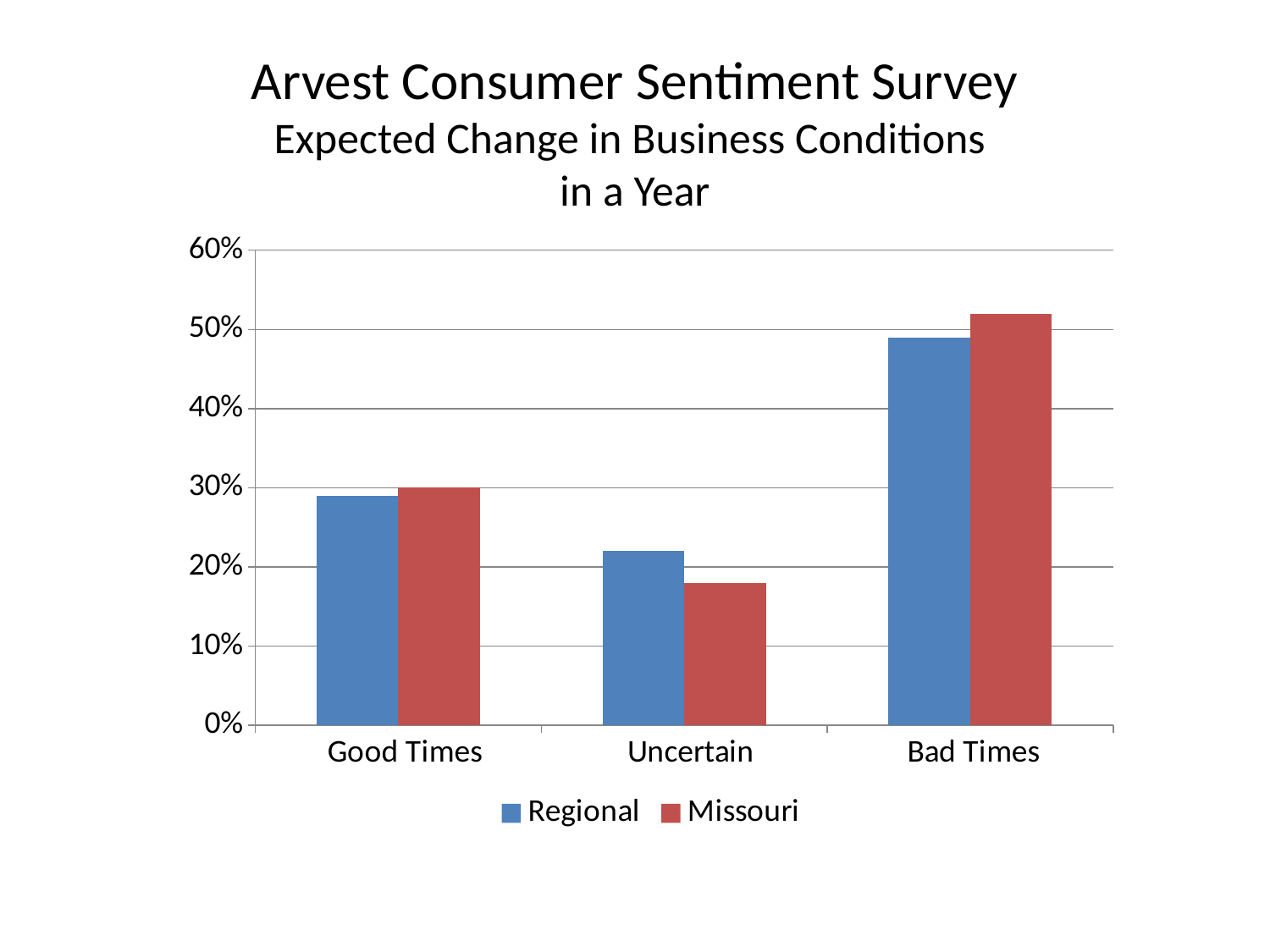
What kind of chart is shown on the slide? bar chart For Uncertain, which series has the larger value, Regional or Missouri? Regional Which category has the highest Regional value? Bad Times What are the two series named in the legend? Regional and Missouri How many categories are shown on the x axis? 3 Is the Regional value for Bad Times greater or less than 40%? greater For Bad Times, which series has the larger value, Regional or Missouri? Missouri Which category has the lowest Missouri value? Uncertain Is the Missouri value for Uncertain greater or less than 20%? less Is the Regional value for Good Times greater or less than 20%? greater Which category has the lowest Regional value? Uncertain How many series does the legend list? 2